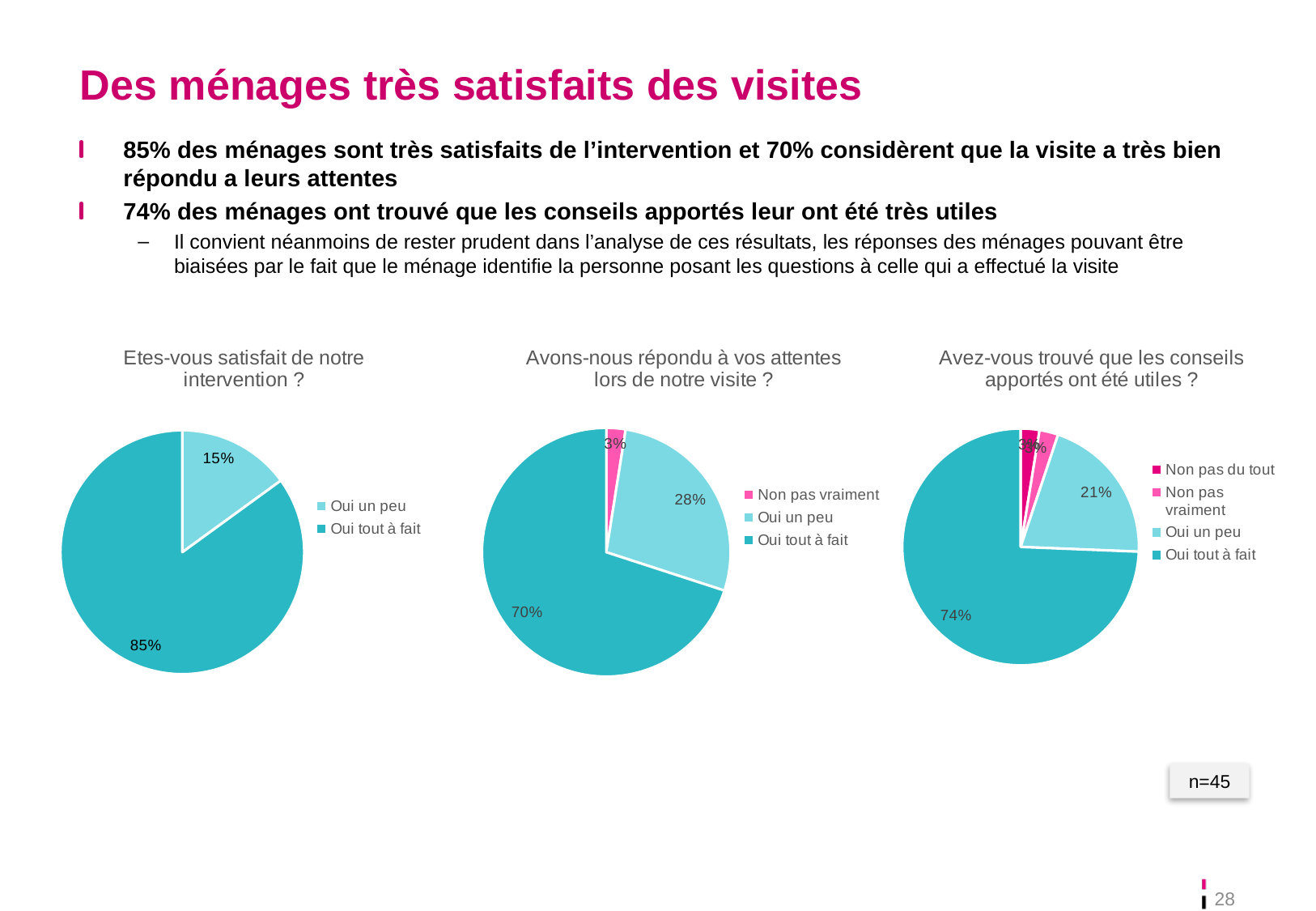
In the chart titled "Etes-vous satisfait de notre intervention ?", what percentage of households answered "Oui tout à fait"? 85% In the chart titled "Etes-vous satisfait de notre intervention ?", what is the difference between the "Oui tout à fait" and "Oui un peu" shares? 70 percentage points In the chart titled "Etes-vous satisfait de notre intervention ?", what percentage answered "Oui un peu"? 15% Which is larger in the chart titled "Avons-nous répondu à vos attentes lors de notre visite ?": the "Oui un peu" share or the "Oui tout à fait" share? Oui tout à fait In the chart titled "Avez-vous trouvé que les conseils apportés ont été utiles ?", what percentage answered "Oui tout à fait"? 74% In the chart titled "Avons-nous répondu à vos attentes lors de notre visite ?", what percentage answered "Oui un peu"? 28% In the chart titled "Avons-nous répondu à vos attentes lors de notre visite ?", which response has the smallest share? Non pas vraiment In the chart titled "Avons-nous répondu à vos attentes lors de notre visite ?", what percentage answered "Non pas vraiment"? 3% In the chart titled "Avez-vous trouvé que les conseils apportés ont été utiles ?", what percentage answered "Oui un peu"? 21% In the chart titled "Avons-nous répondu à vos attentes lors de notre visite ?", which response has the largest share? Oui tout à fait How many entries does the legend of the chart titled "Avez-vous trouvé que les conseils apportés ont été utiles ?" list? 4 What type of chart is used for "Etes-vous satisfait de notre intervention ?"? Pie chart